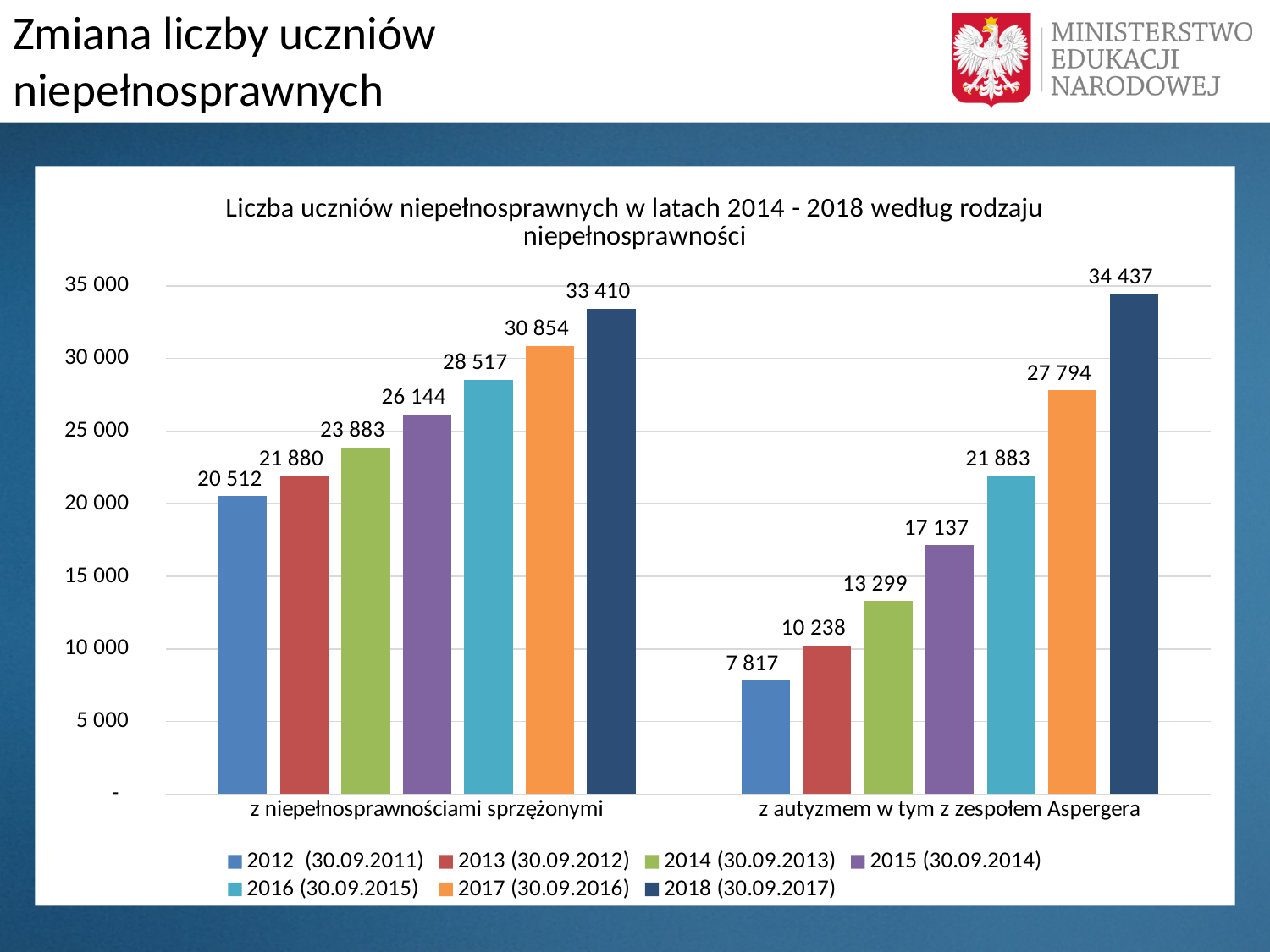
Do the values for 'z autyzmem w tym z zespołem Aspergera' rise or fall from 2012 (30.09.2011) to 2018 (30.09.2017)? Rise What is the value for 2012 (30.09.2011) in the category 'z niepełnosprawnościami sprzężonymi'? 20 512 Which is larger: the 2018 (30.09.2017) value for 'z niepełnosprawnościami sprzężonymi' or for 'z autyzmem w tym z zespołem Aspergera'? z autyzmem w tym z zespołem Aspergera How many categories are shown on the x axis? 2 What is the difference between the 2018 (30.09.2017) and 2017 (30.09.2016) values in the category 'z autyzmem w tym z zespołem Aspergera'? 6 643 By how much did the value for 'z niepełnosprawnościami sprzężonymi' increase from 2012 (30.09.2011) to 2018 (30.09.2017)? 12 898 How many series does the legend list? 7 What is the value for 2015 (30.09.2014) in the category 'z autyzmem w tym z zespołem Aspergera'? 17 137 What is the value for 2018 (30.09.2017) in the category 'z autyzmem w tym z zespołem Aspergera'? 34 437 Which series has the lowest value in the category 'z autyzmem w tym z zespołem Aspergera'? 2012 (30.09.2011) What kind of chart is shown on the slide? Bar chart Which series has the highest value in the category 'z niepełnosprawnościami sprzężonymi'? 2018 (30.09.2017)